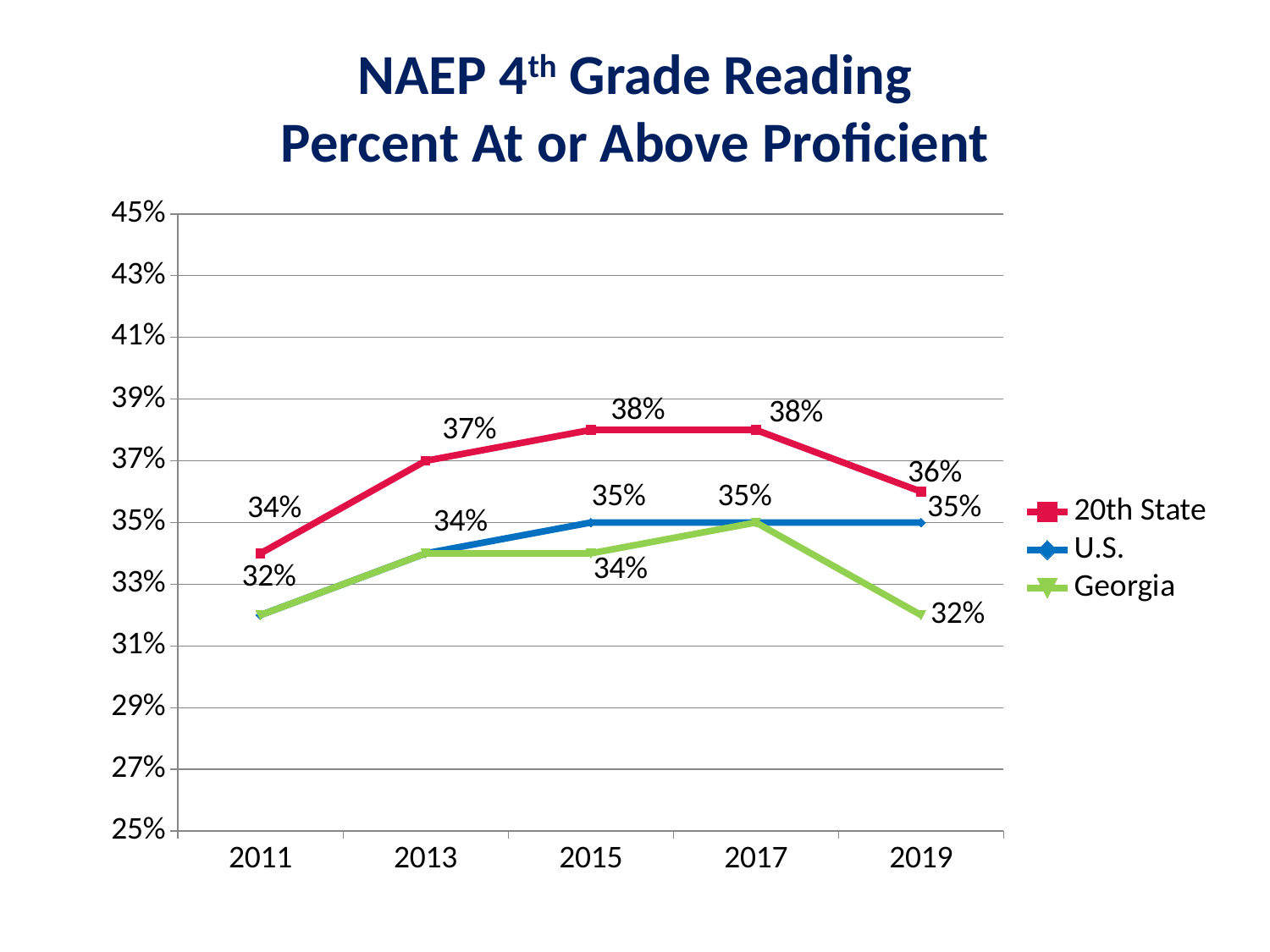
Is the 20th State value for 2017 greater or less than 37%? greater In which year is the 20th State value lowest? 2011 What is the 20th State value for 2015? 38% How many series does the legend list? 3 In which year is Georgia's value highest? 2017 Does the 20th State value rise or fall from 2017 to 2019? fall In 2013, which is larger: the 20th State value or Georgia's value? 20th State What kind of chart is shown on the slide? line chart What is Georgia's value for 2019? 32% How many years are shown on the x axis? 5 What is the difference between the 20th State value and Georgia's value in 2019? 4 percentage points What is the U.S. value for 2017? 35%